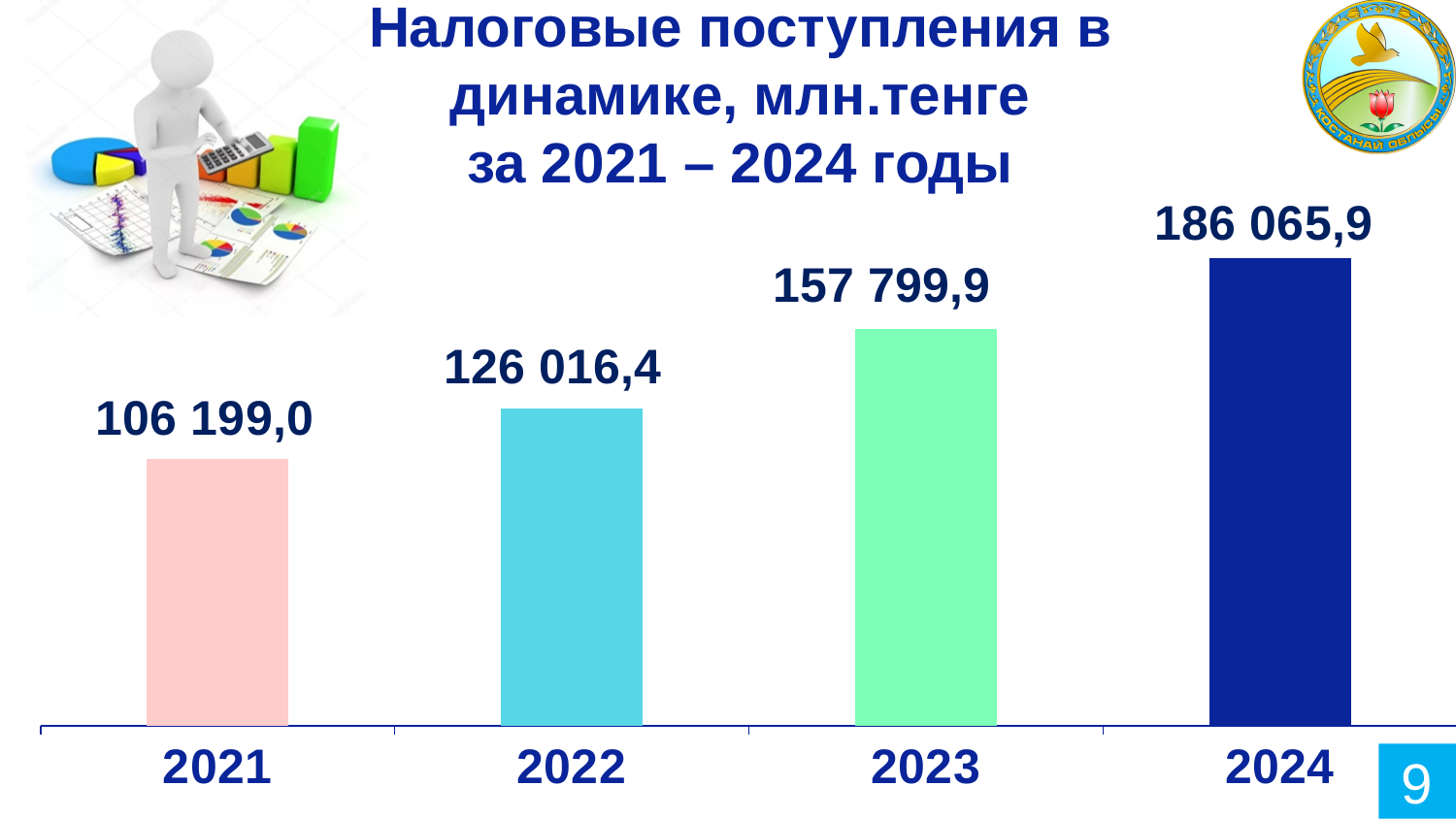
Do the tax revenues rise or fall from 2021 to 2024? Rise What type of chart is shown on the slide? Bar chart What were the tax revenues in 2021? 106 199,0 Which is larger, the value for 2022 or the value for 2023? 2023 What value is shown for 2023? 157 799,9 What value is shown for 2022? 126 016,4 By how much did tax revenues increase from 2021 to 2024? 79 866,9 How many years are shown on the chart? 4 What were the tax revenues in 2024? 186 065,9 What is the difference between the 2023 and 2022 values? 31 783,5 Which year has the highest tax revenues? 2024 Which year has the lowest tax revenues? 2021